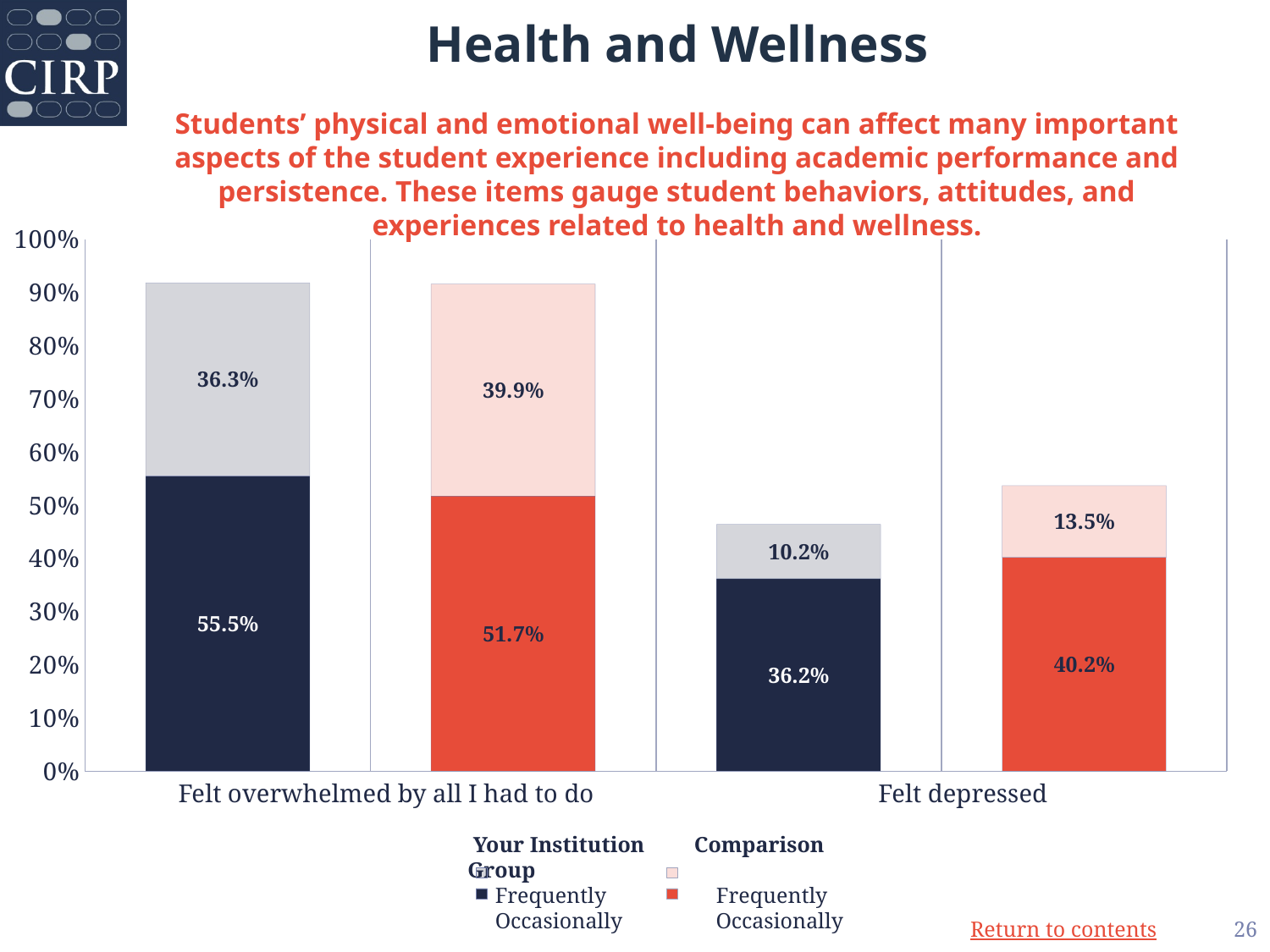
What percentage of students at Your Institution reported frequently feeling depressed? 10.2% What type of chart is shown on the slide? Stacked bar chart What percentage of the Comparison Group reported occasionally feeling depressed? 40.2% What percentage of the Comparison Group reported occasionally feeling overwhelmed by all they had to do? 51.7% What is the combined percentage (frequently plus occasionally) for Your Institution students who felt overwhelmed by all they had to do? 91.8% Which group has a higher percentage of students who frequently felt overwhelmed by all they had to do, Your Institution or the Comparison Group? Comparison Group What is the difference between the Comparison Group and Your Institution in the percentage who frequently felt depressed? 3.3% What percentage of students at Your Institution reported frequently feeling overwhelmed by all they had to do? 36.3% What colour represents the Comparison Group's 'Frequently' responses? Light pink Which of the four stacked bars has the lowest total height? Your Institution, Felt depressed How many series does the legend list? 4 What is the combined percentage (frequently plus occasionally) for the Comparison Group who felt depressed? 53.7%